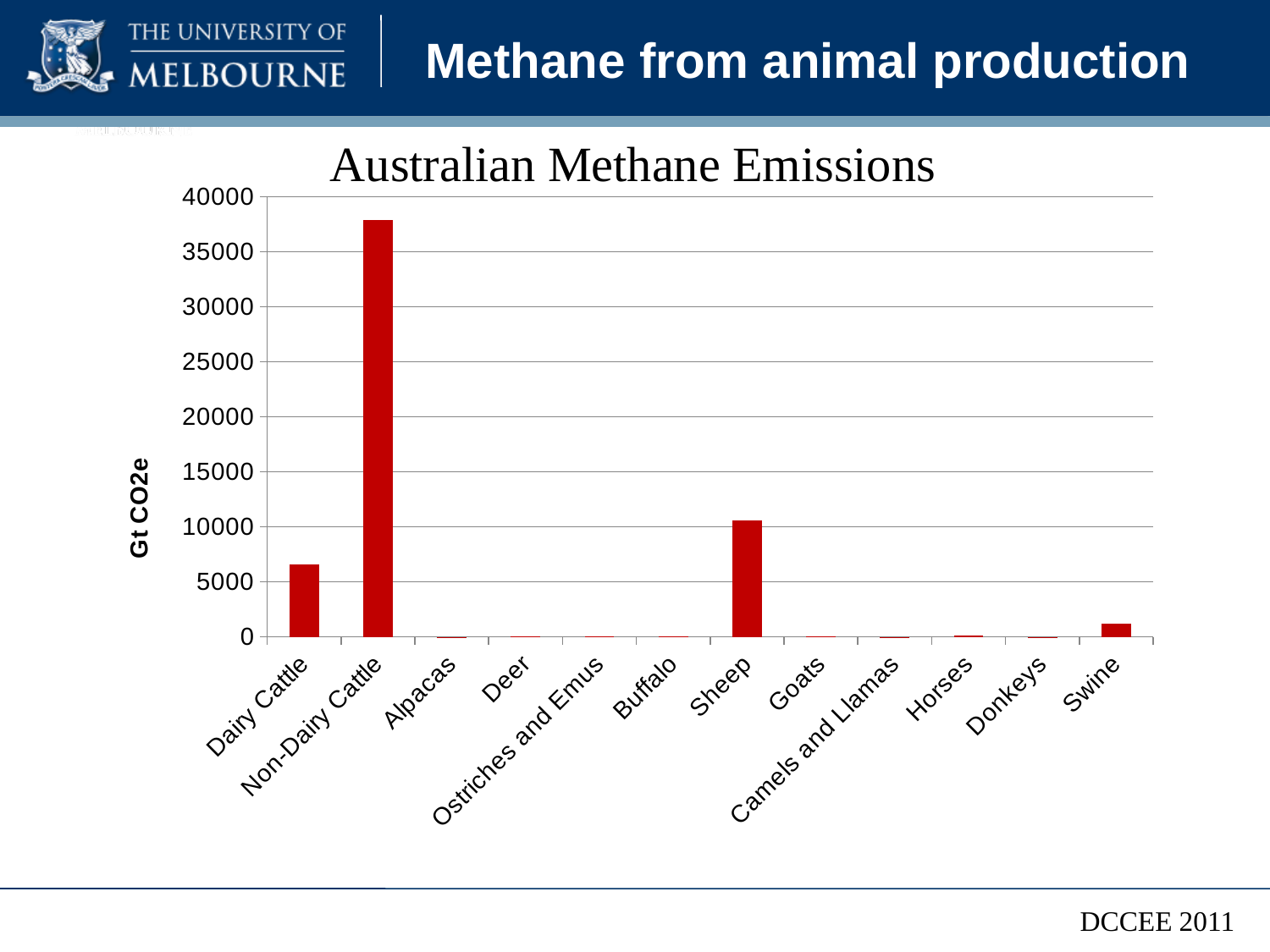
Is the value for Sheep greater or less than 15000? less Is the value for Swine greater or less than 5000? less What is the title of the chart? Australian Methane Emissions Is the value for Non-Dairy Cattle greater or less than 35000? greater Which has higher methane emissions, Sheep or Non-Dairy Cattle? Non-Dairy Cattle How many animal categories are shown on the x axis of the chart? 12 What kind of chart is shown on the slide? bar chart What is the label on the vertical axis of the chart? Gt CO2e Which has higher methane emissions, Swine or Dairy Cattle? Dairy Cattle Which has higher methane emissions, Dairy Cattle or Sheep? Sheep Which animal category has the highest methane emissions in the chart? Non-Dairy Cattle